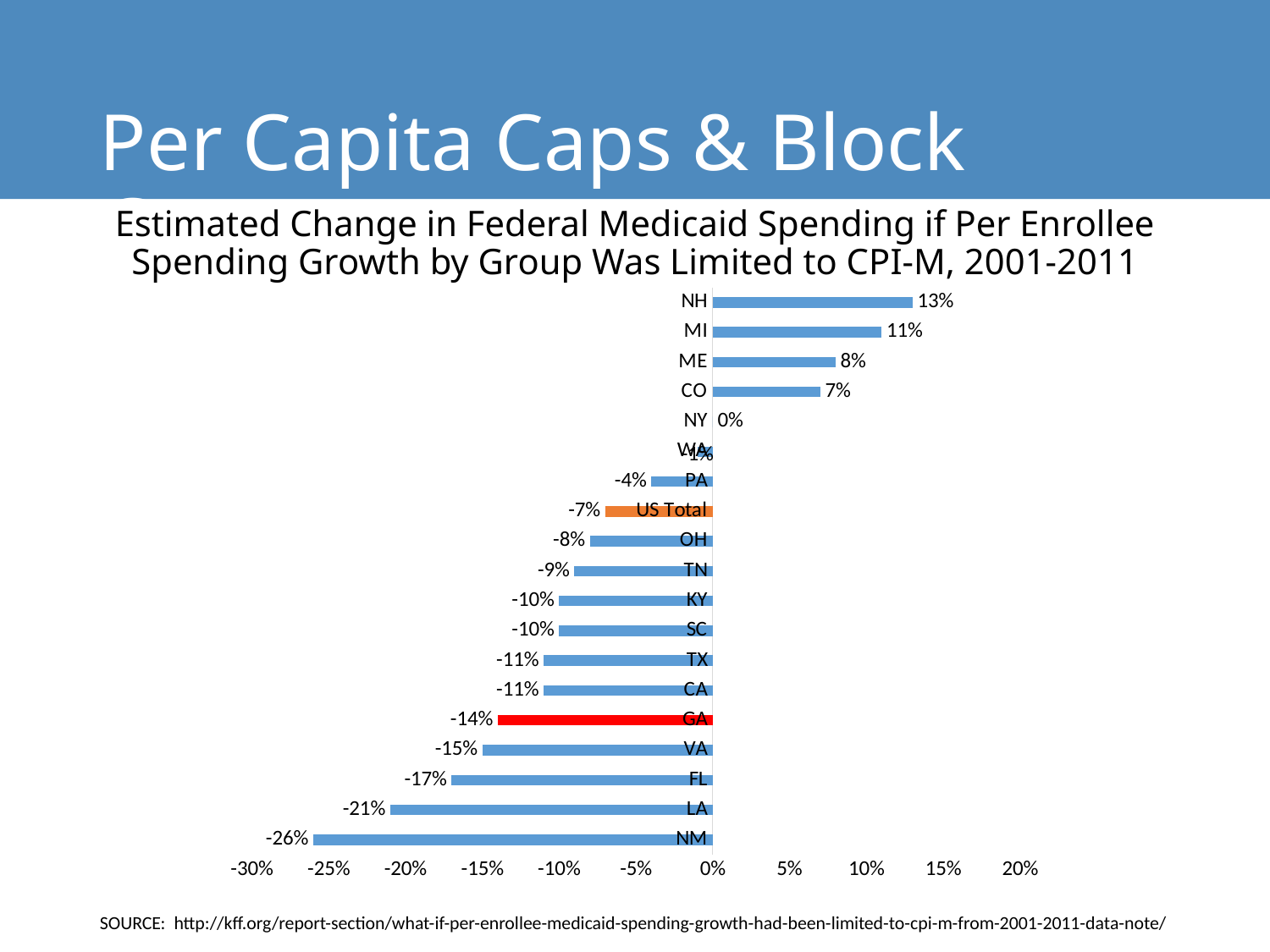
Which state has the highest estimated change in federal Medicaid spending? NH What is the value shown for US Total? -7% What is the value shown for GA? -14% What is the difference between the values for GA and the US Total? 7% What is the estimated change in federal Medicaid spending for NH? 13% What is the value shown for NM? -26% How many categories (bars) are shown in the chart? 19 What is the difference between the values for NH and MI? 2% Which has a larger value, ME or CO? ME What kind of chart is shown on the slide? Bar chart Which state has the lowest estimated change in federal Medicaid spending? NM Which bar is highlighted in red? GA